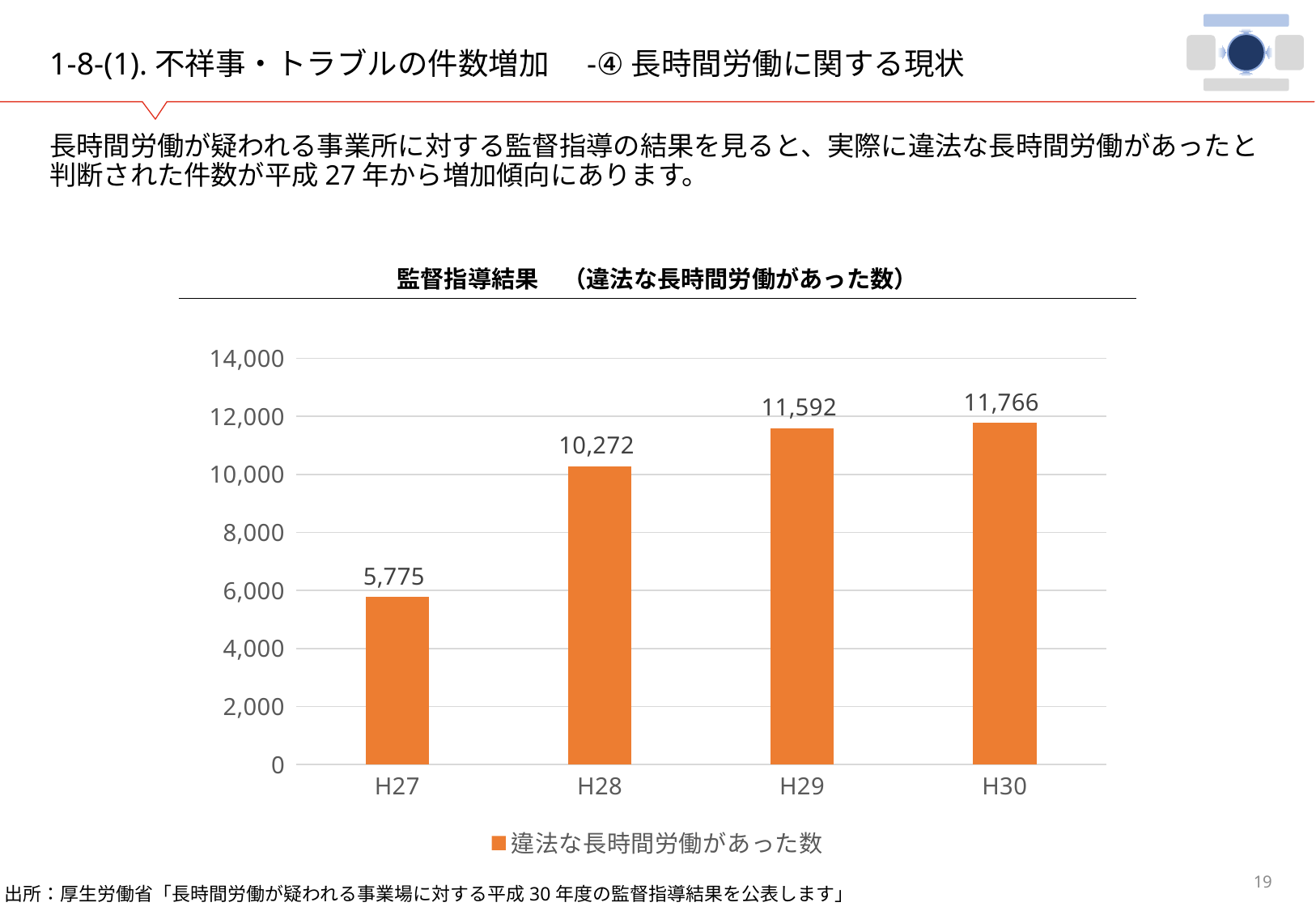
Which year has the highest value? H30 Which is larger, the value for H28 or the value for H29? H29 Do the values rise or fall from H27 to H30? rise What is the value for H29? 11,592 What is the difference between the values for H28 and H27? 4,497 Which year has the lowest value? H27 What is the value for H27? 5,775 What kind of chart is shown? bar chart How many years are shown on the x axis? 4 Is the value for H28 greater or less than 10,000? greater What is the difference between the values for H30 and H29? 174 What is the value for H30? 11,766